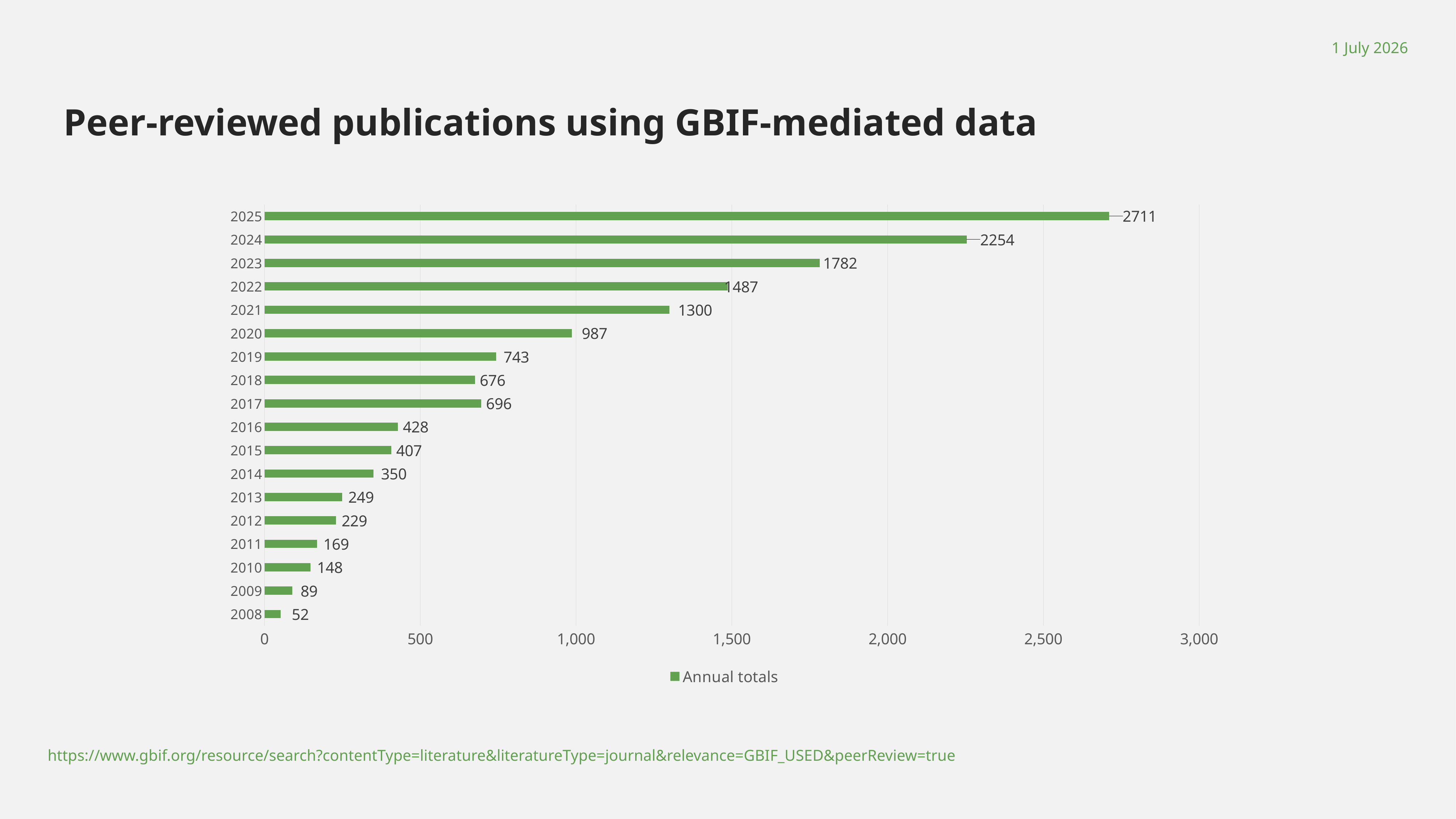
What kind of chart is shown? bar chart What is the legend entry for the series? Annual totals What is the difference between the values for 2025 and 2024? 457 What is the value for 2025? 2711 How many years are shown in the chart? 18 Which is larger, the value for 2018 or the value for 2017? 2017 Which year has the highest value? 2025 What is the value for 2008? 52 What is the value for 2017? 696 Is the value for 2020 greater or less than 1,000? less How many series does the legend list? 1 Which year has the lowest value? 2008